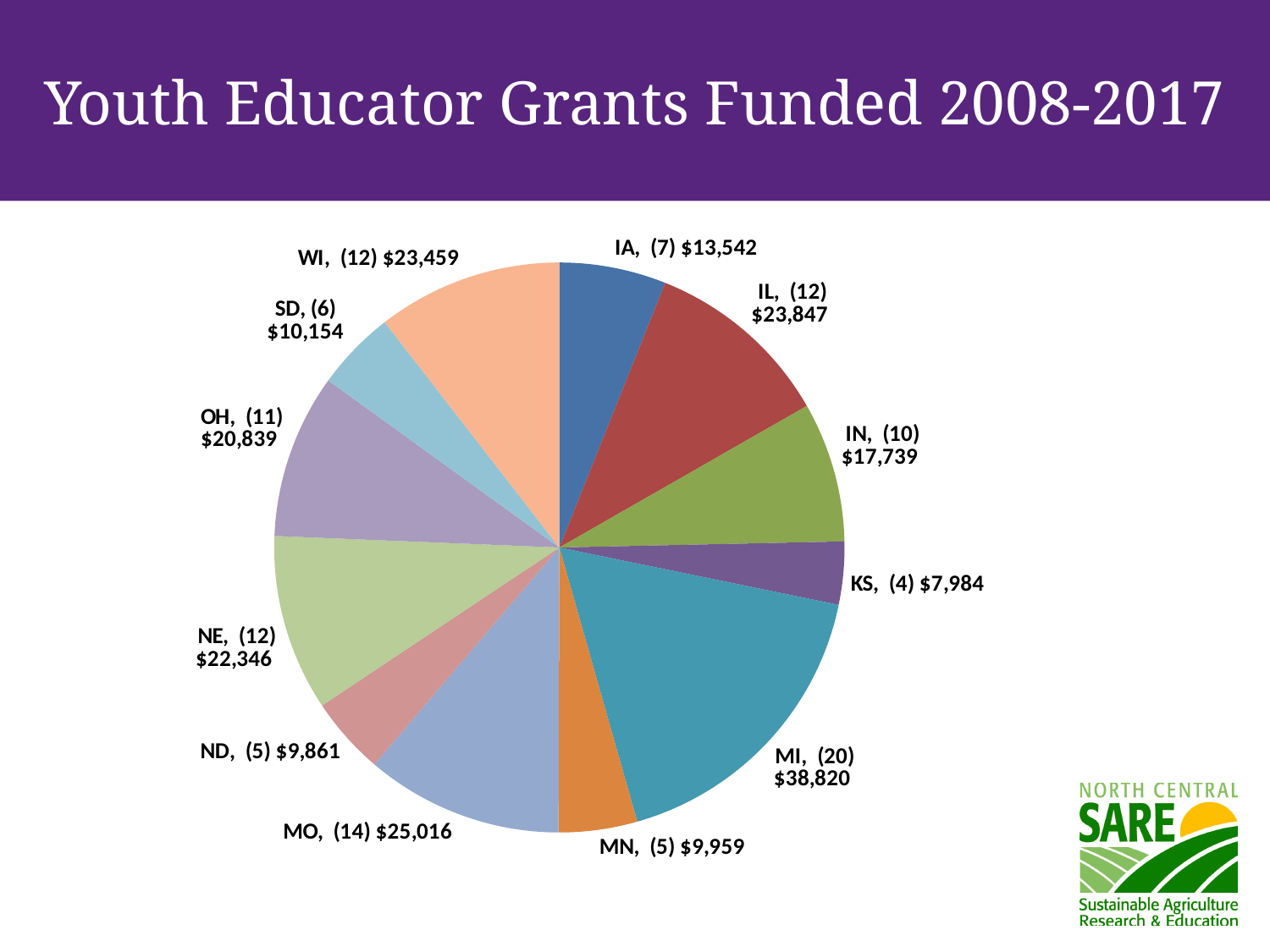
How many states (slices) are shown in the pie chart? 12 What is the title of the slide containing the pie chart? Youth Educator Grants Funded 2008-2017 Which has the larger funding amount, MI or MO? MI What is the funding amount shown for MI? $38,820 Which state has the largest funding amount in the pie chart? MI What kind of chart is shown on the slide? pie chart Which state has the smallest funding amount in the pie chart? KS How many grants are shown in parentheses for MO? 14 Which has the larger funding amount, NE or SD? NE What is the difference between the funding amounts for MI and KS? $30,836 What is the funding amount shown for OH? $20,839 What is the difference between the funding amounts for MO and MN? $15,057